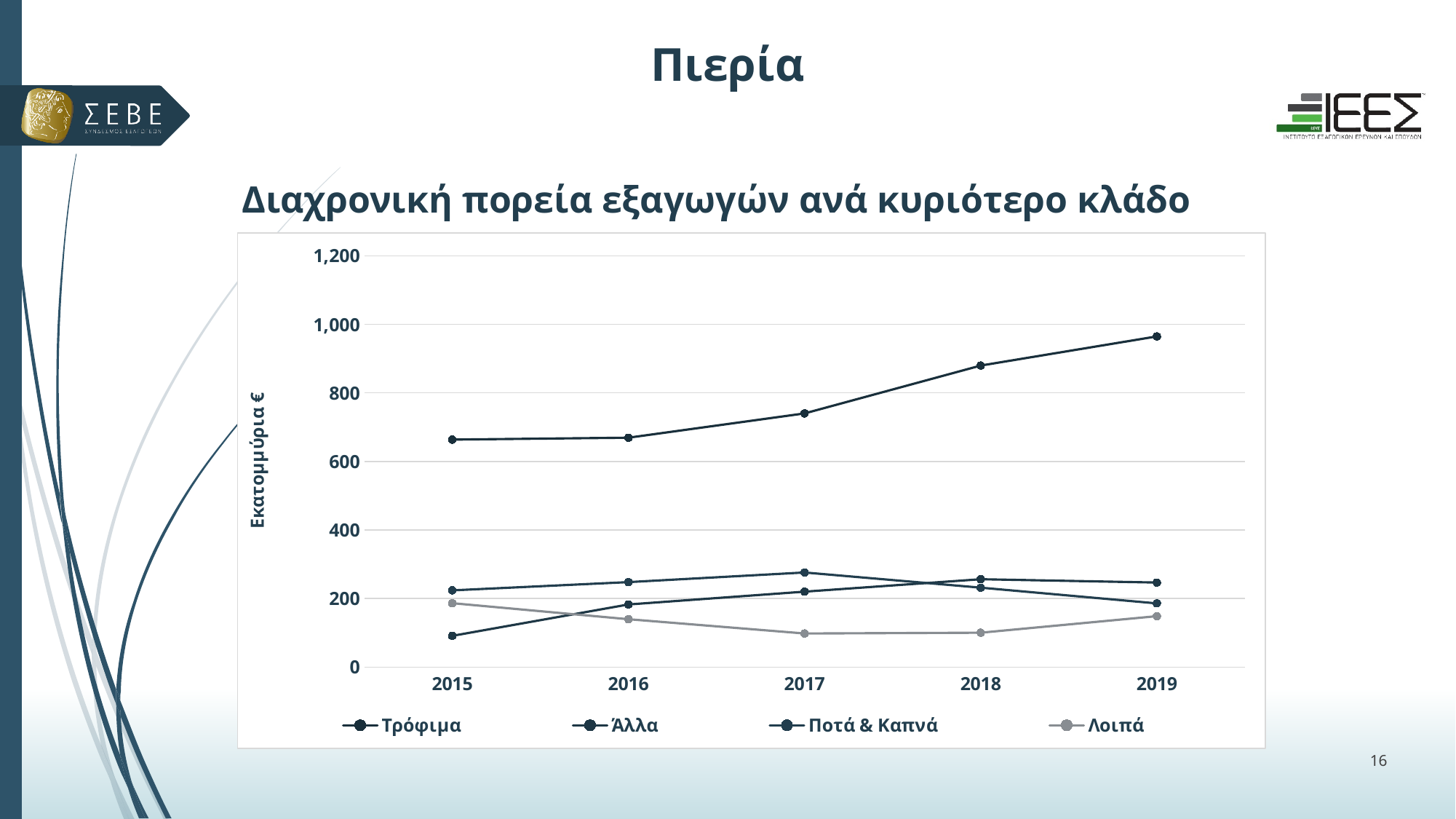
How many years are shown on the x axis? 5 What is the title of the chart? Διαχρονική πορεία εξαγωγών ανά κυριότερο κλάδο Is the value for Λοιπά in 2017 greater or less than 200? less Is the 2015 value of the highest line greater or less than 600? greater Is the 2019 value of the highest line greater or less than 1,000? less What kind of chart is shown on the slide? line chart Which is larger for Λοιπά, the value in 2015 or the value in 2017? 2015 What is the label of the vertical axis? Εκατομμύρια € Does the highest line on the chart rise or fall from 2015 to 2019? rise In which year is the value for Λοιπά highest? 2015 How many series does the legend list? 4 In which year does the highest line on the chart reach its maximum value? 2019